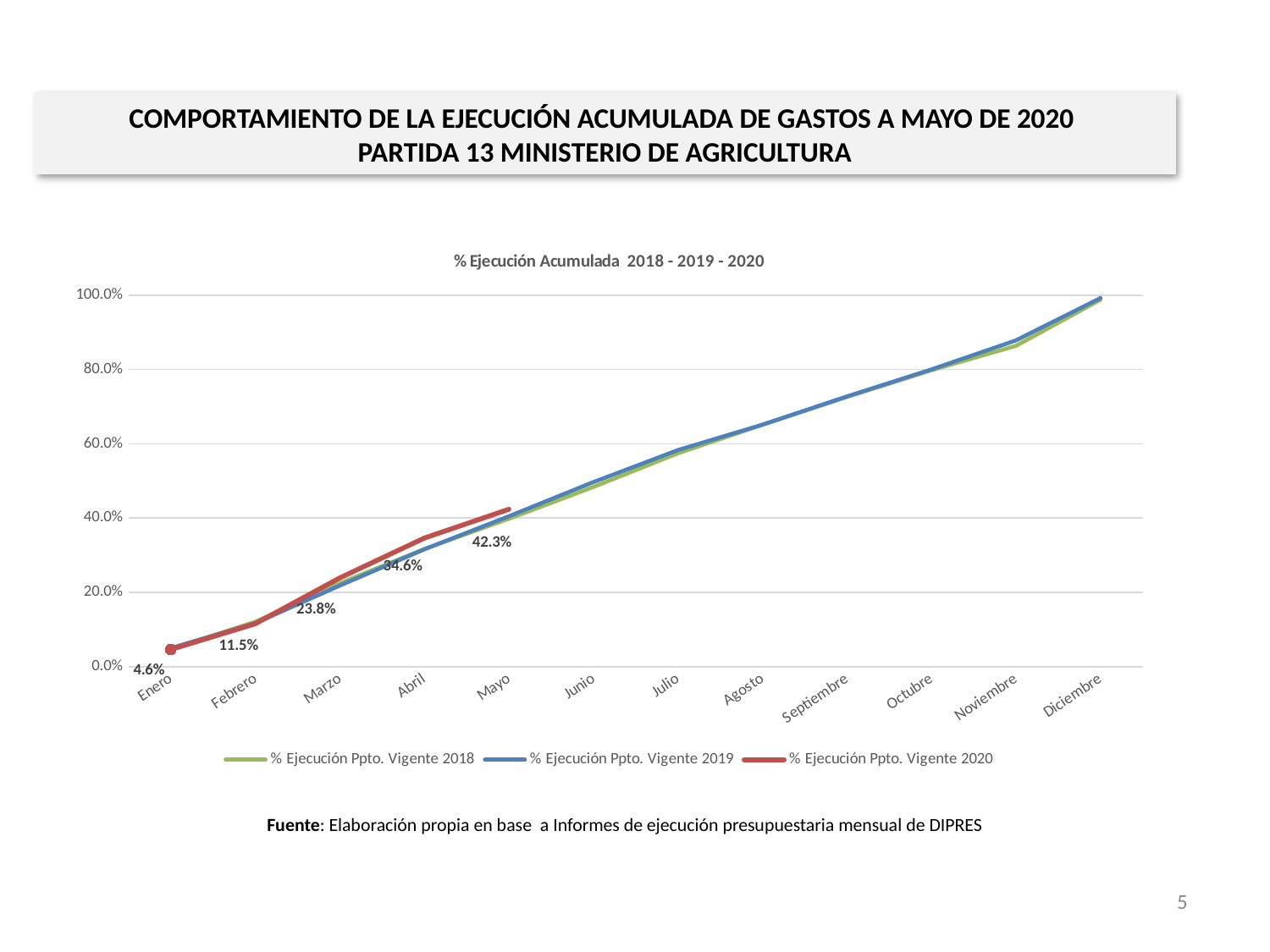
What is the value of % Ejecución Ppto. Vigente 2020 in Abril? 34.6% What is the value of % Ejecución Ppto. Vigente 2020 in Febrero? 11.5% What is the value of % Ejecución Ppto. Vigente 2020 in Enero? 4.6% How many months are shown on the x axis? 12 What is the value of % Ejecución Ppto. Vigente 2020 in Marzo? 23.8% What is the title of the chart? % Ejecución Acumulada 2018 - 2019 - 2020 How many series does the legend list? 3 Does the % Ejecución Ppto. Vigente 2019 series rise or fall from Enero to Diciembre? rise What is the value of % Ejecución Ppto. Vigente 2020 in Mayo? 42.3% What is the difference between the 2020 values for Mayo and Abril? 7.7% Is the value of % Ejecución Ppto. Vigente 2019 in Octubre greater or less than 60.0%? greater What type of chart is shown on the slide? line chart